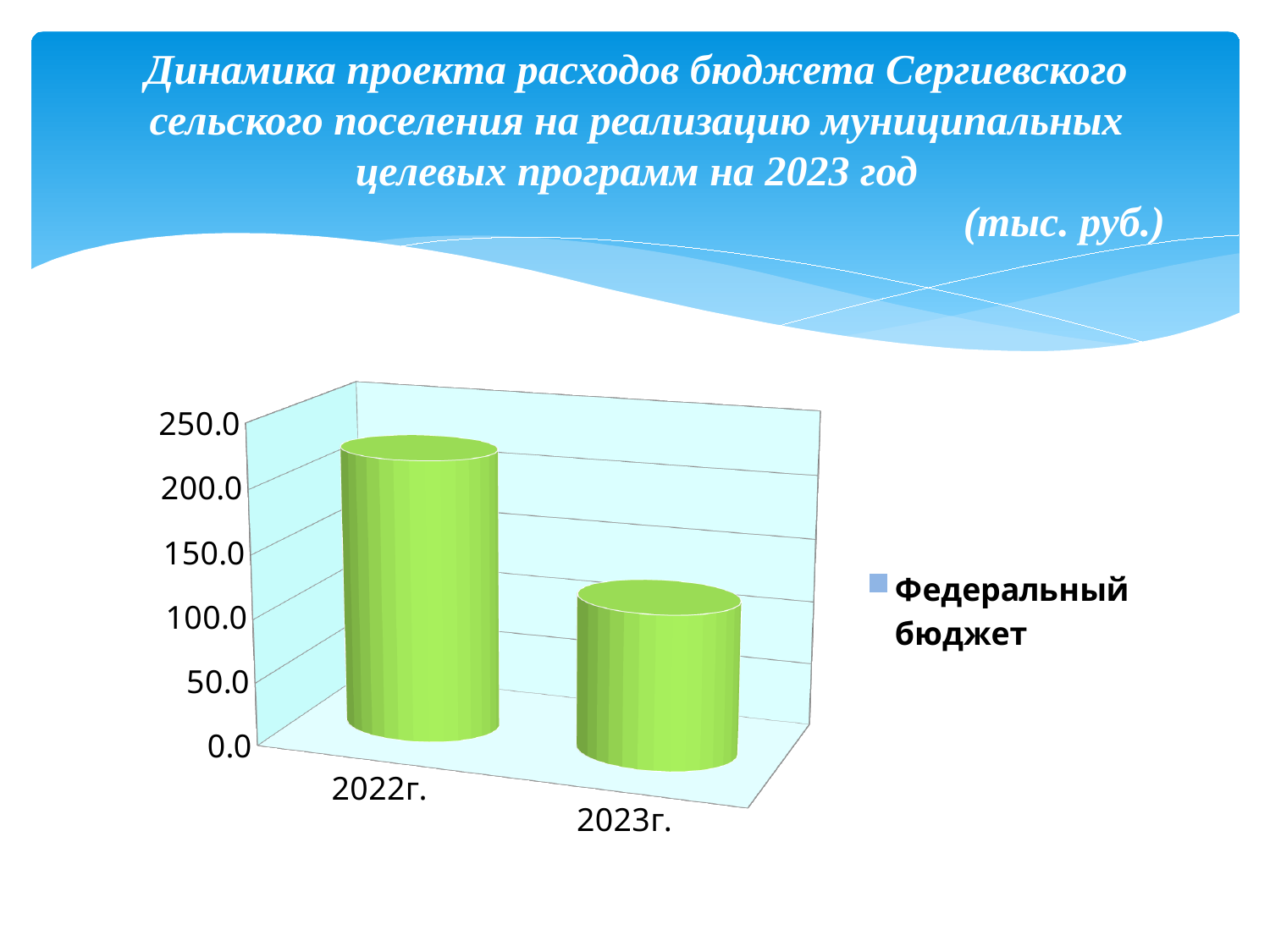
Is the value for 2023г. greater or less than 100? greater Is the value for 2022г. greater or less than 200? greater How many categories are shown on the x axis of the chart? 2 Which category has the highest value? 2022г. What kind of chart is shown on the slide? bar chart What is the name of the series shown in the legend? Федеральный бюджет Which year has the higher value, 2022г. or 2023г.? 2022г. How many series does the legend list? 1 What unit of measurement is stated in the slide title for the chart values? тыс. руб. Do the values rise or fall from 2022г. to 2023г.? fall Is the value for 2023г. greater or less than 200? less Which category has the lowest value? 2023г.